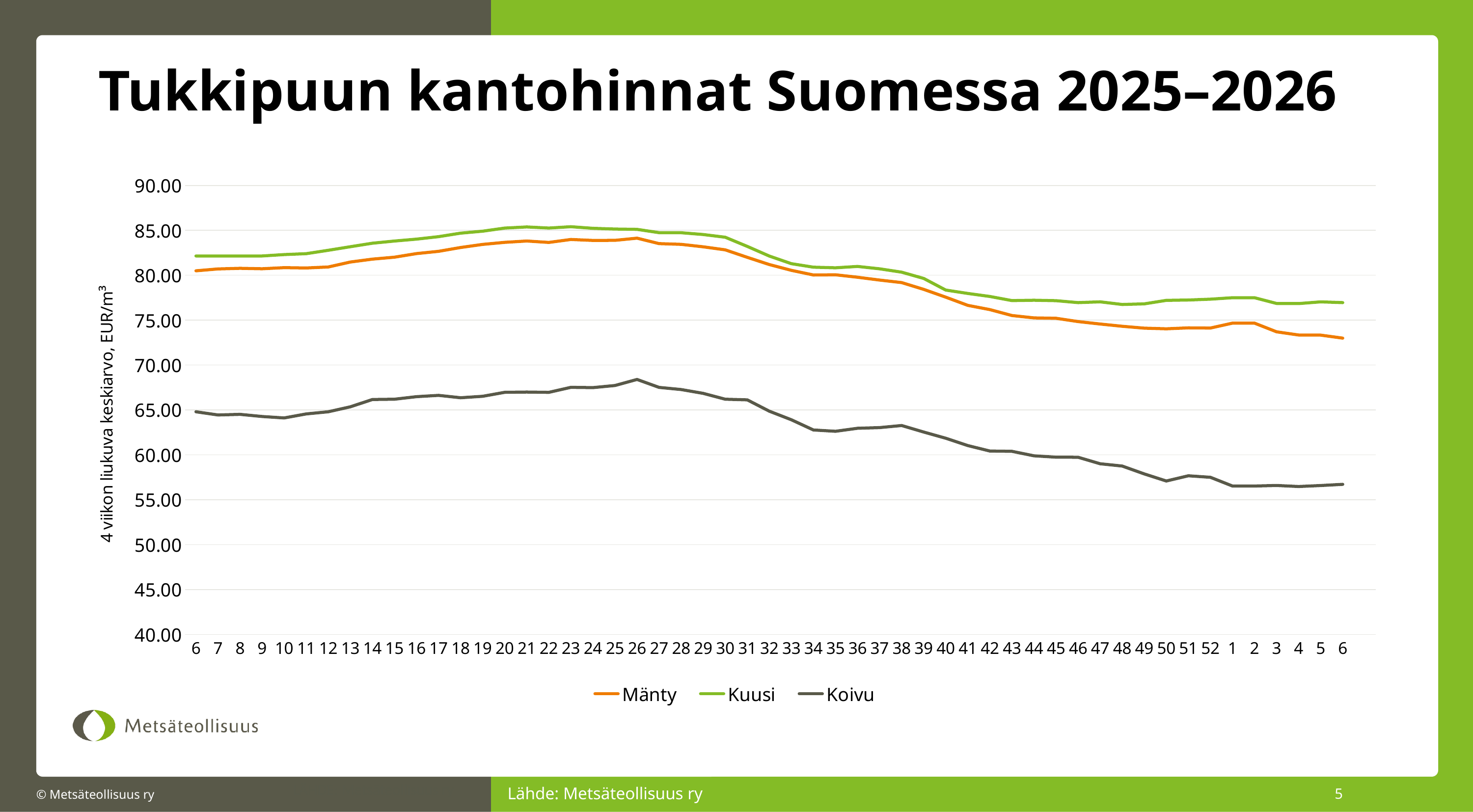
Is the value for Kuusi at week 40 greater or less than 80? less Is the value for Mänty at the last week 6 on the x axis greater or less than 75? less Is the value for Koivu at week 26 greater or less than 65? greater Which series has the highest values throughout the chart? Kuusi What kind of chart is shown on the slide? line chart Does the Koivu line rise or fall from week 26 to the end of the x axis? fall How many series does the legend list? 3 Which series has the lowest values throughout the chart? Koivu What is the y-axis label of the chart? 4 viikon liukuva keskiarvo, EUR/m³ At week 26, which is larger, the value for Kuusi or the value for Mänty? Kuusi